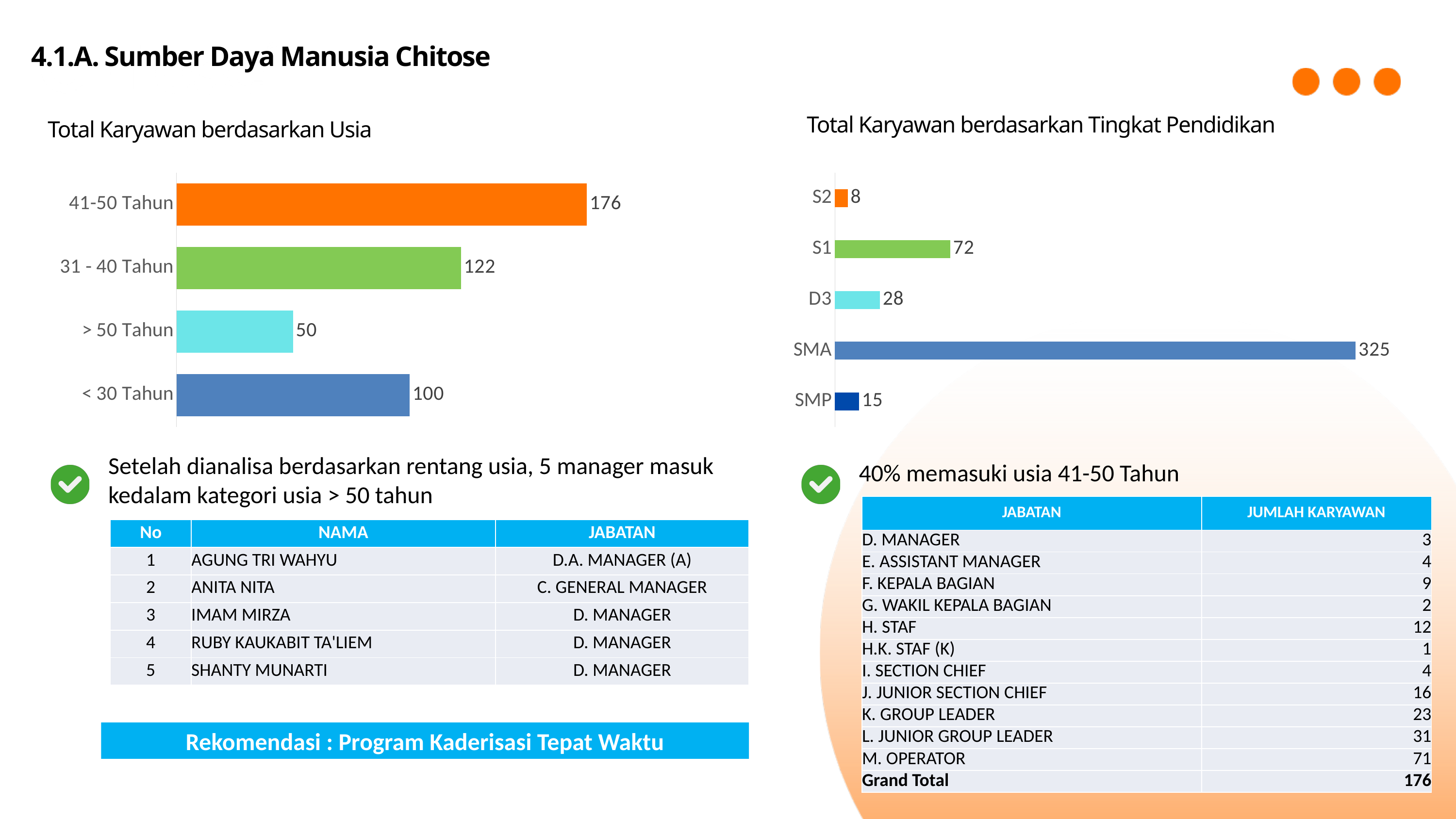
In the 'Total Karyawan berdasarkan Usia' chart, which age category has the highest value? 41-50 Tahun In the 'Total Karyawan berdasarkan Usia' chart, what is the value for 41-50 Tahun? 176 In the 'Total Karyawan berdasarkan Tingkat Pendidikan' chart, what is the difference between the values for S1 and D3? 44 In the 'Total Karyawan berdasarkan Usia' chart, what is the value for > 50 Tahun? 50 In the 'Total Karyawan berdasarkan Tingkat Pendidikan' chart, what is the value for SMA? 325 In the 'Total Karyawan berdasarkan Usia' chart, what is the difference between the values for 41-50 Tahun and 31 - 40 Tahun? 54 In the 'Total Karyawan berdasarkan Tingkat Pendidikan' chart, which education level has the lowest value? S2 In the 'Total Karyawan berdasarkan Tingkat Pendidikan' chart, what is the value for D3? 28 In the 'Total Karyawan berdasarkan Tingkat Pendidikan' chart, which is larger, the value for S1 or the value for SMP? S1 In the 'Total Karyawan berdasarkan Usia' chart, how many age categories are shown? 4 What kind of chart is 'Total Karyawan berdasarkan Tingkat Pendidikan'? Bar chart In the 'Total Karyawan berdasarkan Usia' chart, which age category has the lowest value? > 50 Tahun